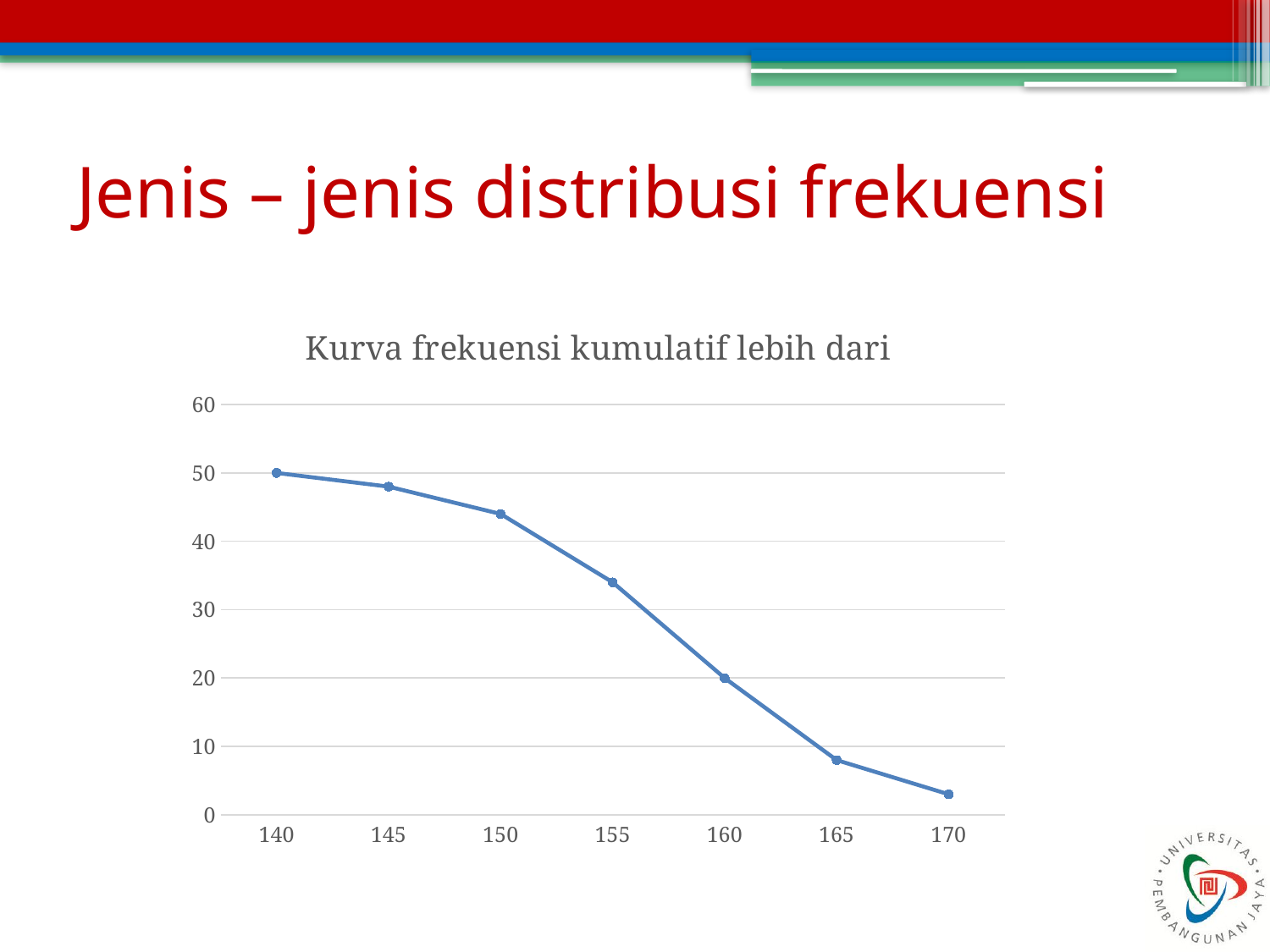
What is the title of the chart? Kurva frekuensi kumulatif lebih dari Which x-axis category has the highest value? 140 What is the value at 160? 20 What is the value at 140? 50 Is the value at 150 greater or less than 40? greater Do the values rise or fall as the x axis goes from 140 to 170? fall Which has the larger value, 155 or 165? 155 Is the value at 165 greater or less than 10? less What kind of chart is shown on the slide? line chart Is the value at 155 greater or less than 30? greater Which x-axis category has the lowest value? 170 How many data points are plotted on the line? 7